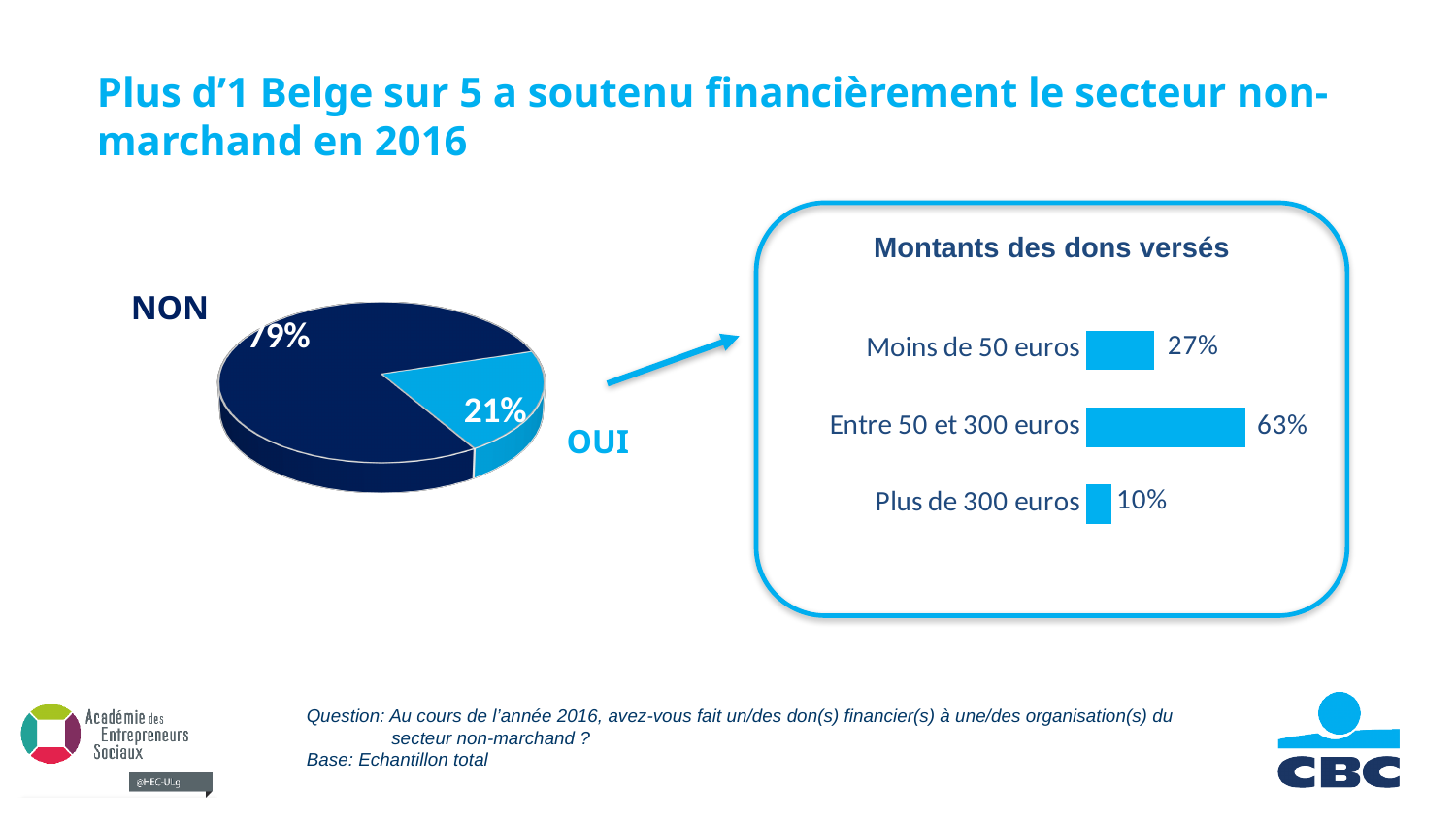
In the 'Montants des dons versés' chart, what is the value for 'Entre 50 et 300 euros'? 63% In the pie chart on the left, which answer has the larger slice, OUI or NON? NON What kind of chart is the chart on the left of the slide? Pie chart In the pie chart on the left, what share of respondents answered NON? 79% In the pie chart on the left, how many slices are there? 2 In the 'Montants des dons versés' chart, which category has the lowest value? Plus de 300 euros In the pie chart on the left, what is the difference in percentage points between the NON and OUI slices? 58 In the 'Montants des dons versés' chart, what is the value for 'Moins de 50 euros'? 27% In the 'Montants des dons versés' chart, what is the difference in percentage points between 'Entre 50 et 300 euros' and 'Moins de 50 euros'? 36 In the 'Montants des dons versés' chart, which category has the highest value? Entre 50 et 300 euros In the pie chart on the left, what share of respondents answered OUI? 21% What kind of chart is the 'Montants des dons versés' chart? Bar chart